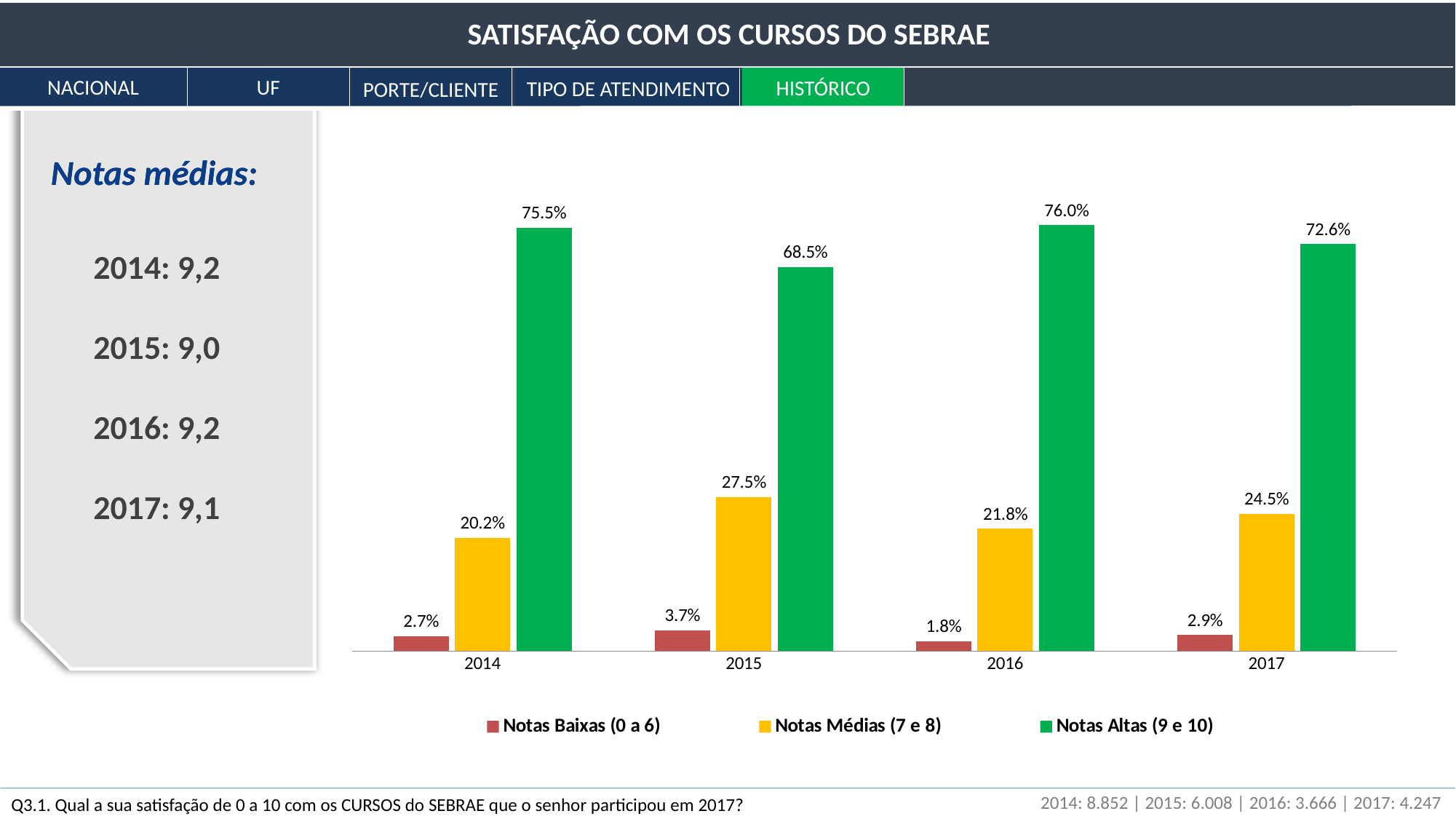
What is the difference between the Notas Altas (9 e 10) values for 2014 and 2017? 2.9% Which colour represents Notas Altas (9 e 10) in the legend? Green How many years are shown on the x axis? 4 What is the value for Notas Altas (9 e 10) in 2016? 76.0% Which is larger: Notas Médias (7 e 8) in 2015 or in 2016? 2015 How many series does the legend list? 3 Does the Notas Médias (7 e 8) value rise or fall from 2016 to 2017? Rise What is the value for Notas Médias (7 e 8) in 2017? 24.5% In which year is the Notas Altas (9 e 10) value the lowest? 2015 What is the value for Notas Baixas (0 a 6) in 2015? 3.7% What kind of chart is shown on the slide? Bar chart In which year is the Notas Baixas (0 a 6) value the highest? 2015